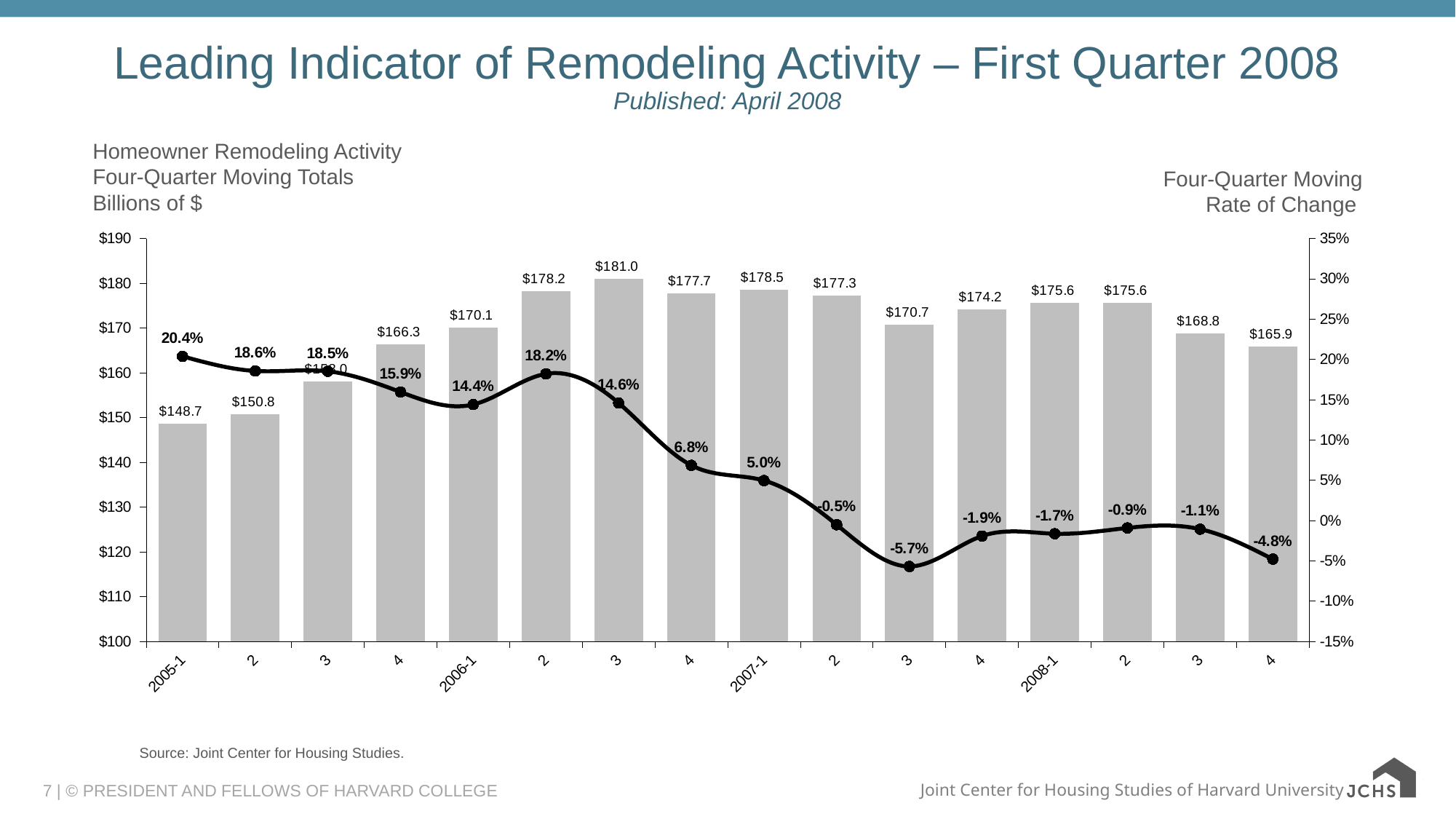
What is the four-quarter moving rate of change for the first quarter of 2005 (2005-1)? 20.4% Does the four-quarter moving rate of change generally rise or fall from 2005-1 to 2007-3? Fall Which is larger, the four-quarter moving total for the second quarter of 2006 or for the first quarter of 2006? Second quarter of 2006 ($178.2) What is the four-quarter moving rate of change for the third quarter of 2007? -5.7% What is the difference between the four-quarter moving totals for the third quarter of 2006 and the first quarter of 2005? $32.3 Which quarter has the lowest four-quarter moving total (bar)? 2005-1 Which quarter has the highest four-quarter moving total (bar)? 2006-3 What is the four-quarter moving total shown for the fourth quarter of 2008? $165.9 What is the four-quarter moving total of homeowner remodeling activity for the third quarter of 2006? $181.0 How many quarters are plotted on the x axis? 16 Which quarter has the lowest four-quarter moving rate of change (line)? 2007-3 What kind of chart is this? Combination bar and line chart